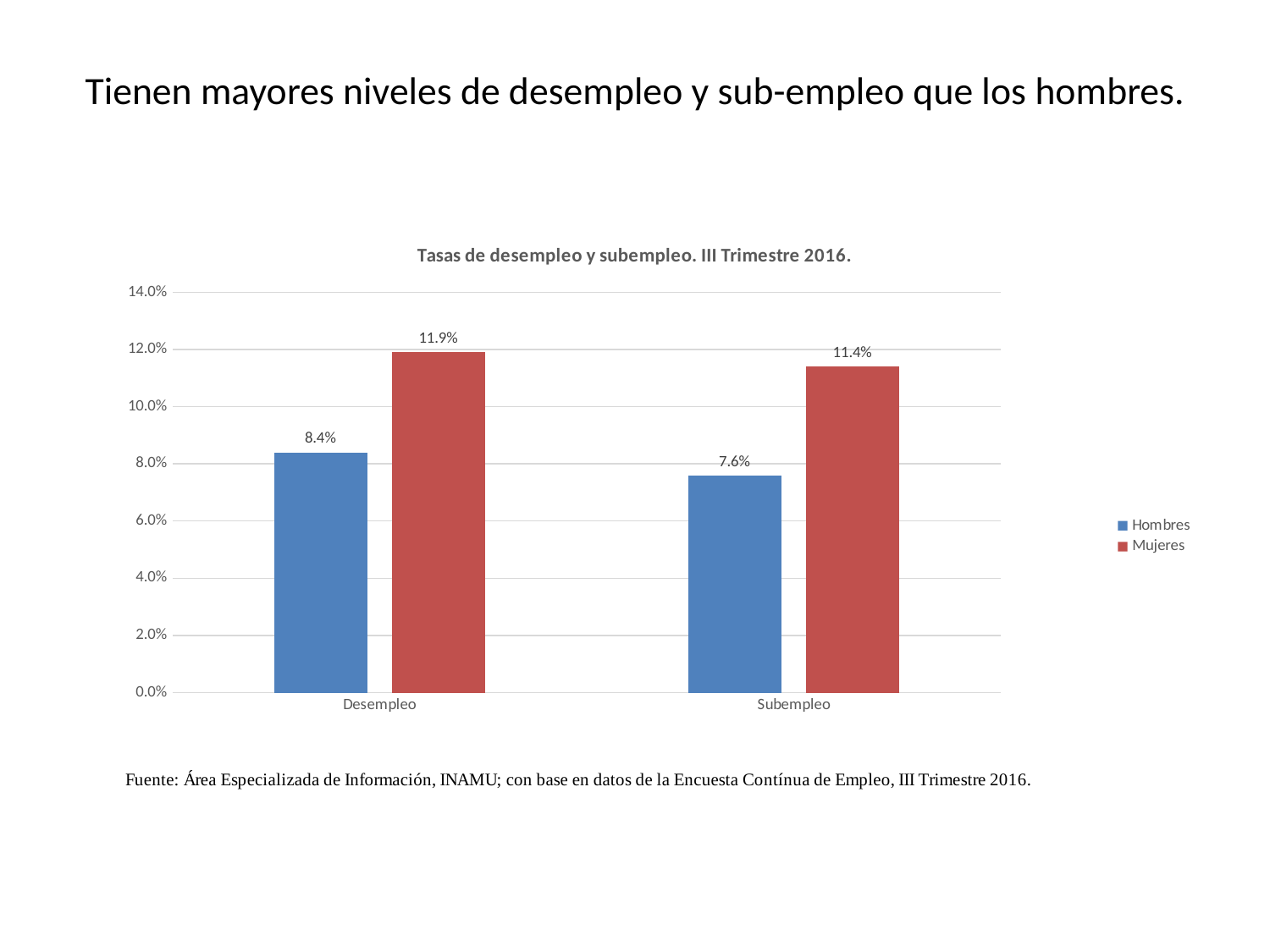
What is the value for Hombres in the Subempleo category? 7.6% What kind of chart is shown on the slide? Bar chart What is the value for Mujeres in the Desempleo category? 11.9% What is the value for Hombres in the Desempleo category? 8.4% What is the value for Mujeres in the Subempleo category? 11.4% How many categories are shown on the x axis? 2 Which series has the highest value in the Desempleo category? Mujeres How many series does the legend list? 2 Which is larger, the Mujeres value for Desempleo or the Mujeres value for Subempleo? Desempleo What is the difference between the Mujeres and Hombres values for Subempleo? 3.8% Which bar has the lowest value in the chart? Hombres, Subempleo What is the difference between the Mujeres and Hombres values for Desempleo? 3.5%